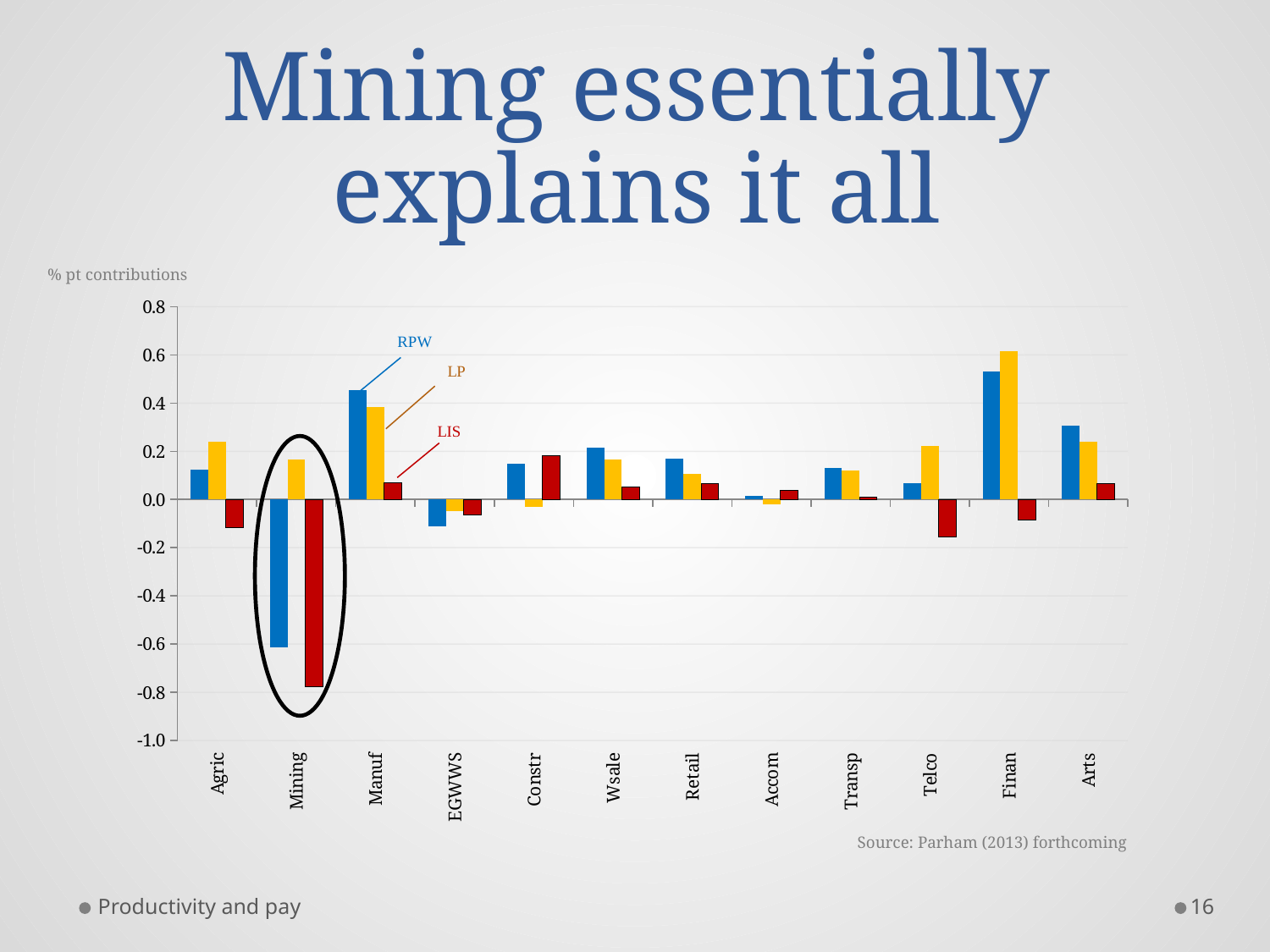
Which category has the lowest RPW value? Mining Is the LP value for Finan greater or less than 0.4? greater For Mining, which is larger, the RPW value or the LIS value? RPW Which category has the highest LP value? Finan Is the LIS value for Mining greater or less than -0.6? less Is the RPW value for Mining greater or less than -0.4? less Which category has the highest RPW value? Finan What kind of chart is shown on the slide? bar chart What is the title of the slide containing the chart? Mining essentially explains it all Which category has the lowest LIS value? Mining How many industry categories are shown on the x axis of the chart? 12 How many series are labelled on the chart? 3